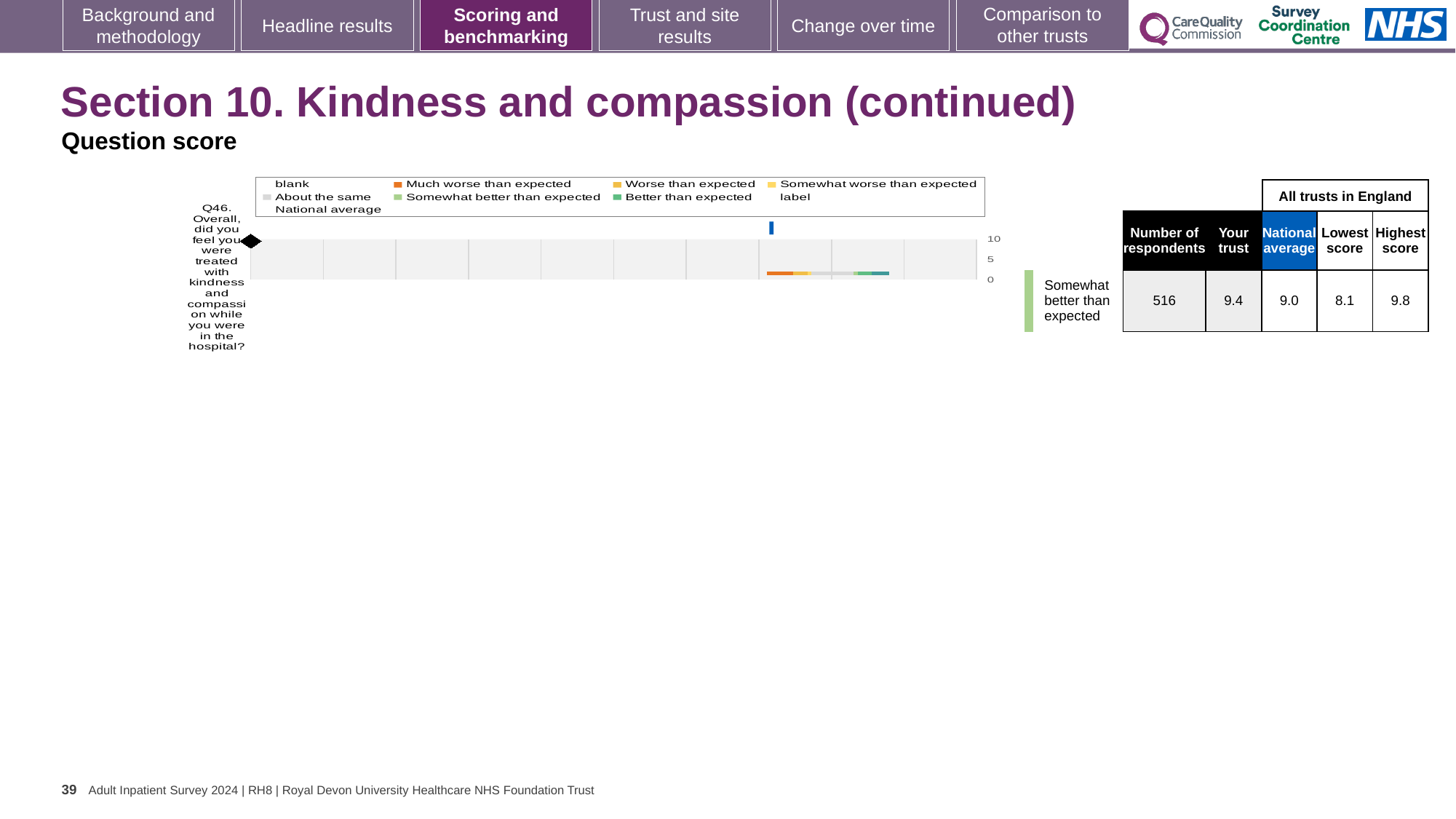
How many respondents answered Q46? 516 How many entries does the chart legend list? 9 What is the 'Your trust' score for Q46 (treated with kindness and compassion)? 9.4 By how much does the 'Your trust' score for Q46 exceed the national average? 0.4 What is the national average score for Q46? 9.0 What is the highest score among all trusts in England for Q46? 9.8 Which benchmarking category is the trust's Q46 result placed in? Somewhat better than expected Which is larger for Q46: the 'Your trust' score or the national average? Your trust What is the difference between the highest and lowest scores for Q46 across all trusts in England? 1.7 How many questions are plotted on the chart? 1 What is the lowest score among all trusts in England for Q46? 8.1 What kind of chart is shown on the slide for Q46? bar chart